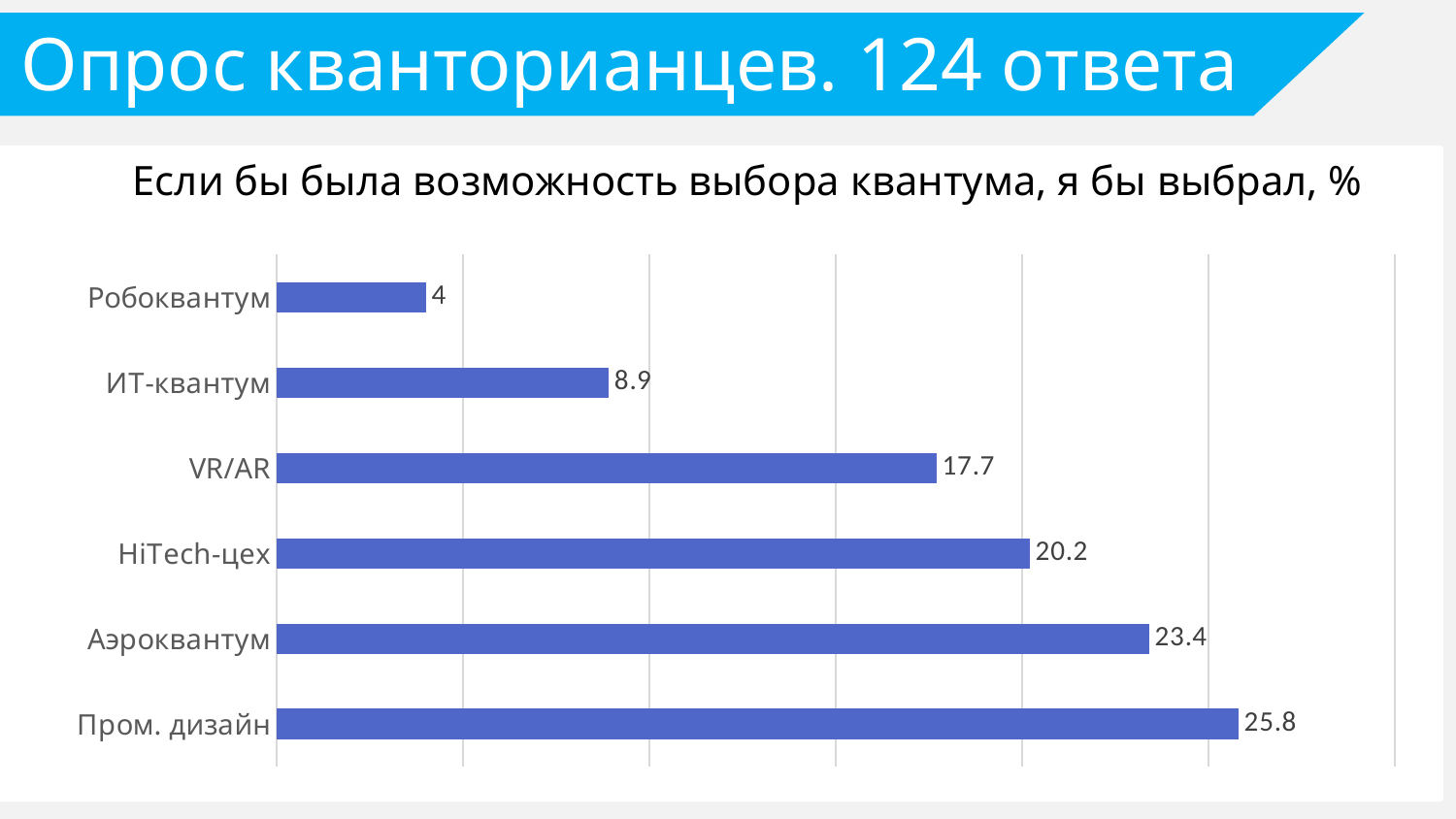
Which category has the lowest value? Робоквантум How many categories are shown in the chart? 6 What is the difference between the values for Пром. дизайн and Робоквантум? 21.8 What colour are the bars in the chart? Blue What is the difference between the values for Аэроквантум and HiTech-цех? 3.2 Which is larger, the value for VR/AR or the value for ИТ-квантум? VR/AR What is the title of the chart? Если бы была возможность выбора квантума, я бы выбрал, % Which category has the highest value? Пром. дизайн What value is shown for Пром. дизайн? 25.8 What value is shown for VR/AR? 17.7 What value is shown for ИТ-квантум? 8.9 What kind of chart is shown on the slide? Bar chart